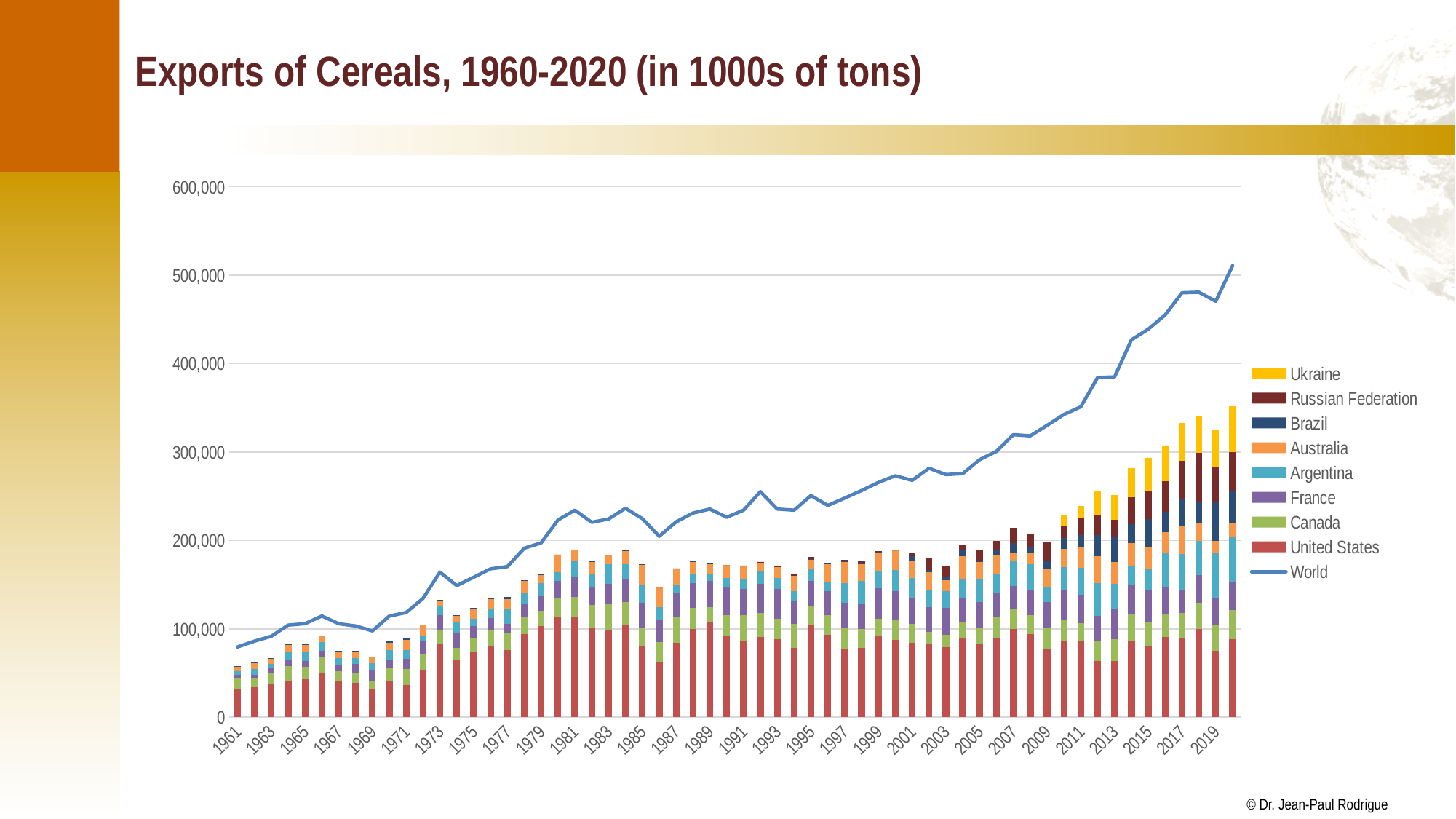
Is the World value for 2017 greater or less than 400,000? greater What kind of chart is shown on the slide? A stacked bar chart combined with a line Is the total height of the stacked bar for 1961 greater or less than 100,000? less Does the World line generally rise or fall from 1961 to the end of the period? rise Is the World value for 1961 greater or less than 100,000? less Which is larger, the World value for 2019 or the World value for 1961? 2019 How many series does the legend list? 9 Which series is plotted as a line rather than as stacked bars? World What is the title of the chart? Exports of Cereals, 1960-2020 (in 1000s of tons) Which is larger, the World value for 1981 or the World value for 1987? 1981